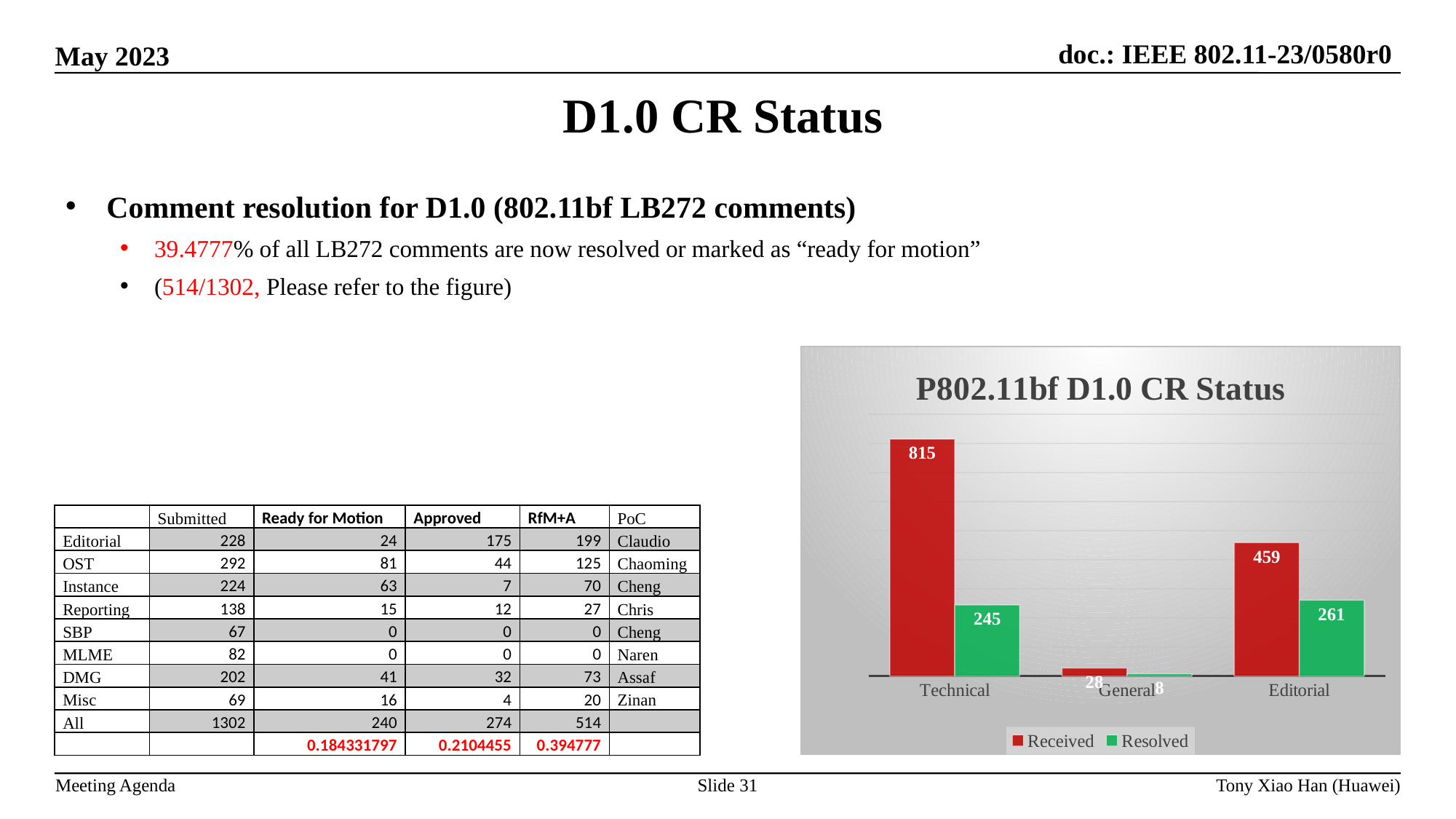
What kind of chart is shown on the slide? bar chart What is the Received value for Technical in the chart? 815 What is the difference between the Received and Resolved values for Technical in the chart? 570 What is the title of the chart on the slide? P802.11bf D1.0 CR Status Is the Resolved value for Editorial larger or smaller than the Resolved value for Technical in the chart? larger Which category has the lowest Resolved value in the chart? General Which category has the highest Received value in the chart? Technical How many series does the chart's legend list? 2 How many categories are shown on the chart's x axis? 3 What is the Resolved value for Editorial in the chart? 261 Which series in the chart is shown in green? Resolved What is the Received value for General in the chart? 28